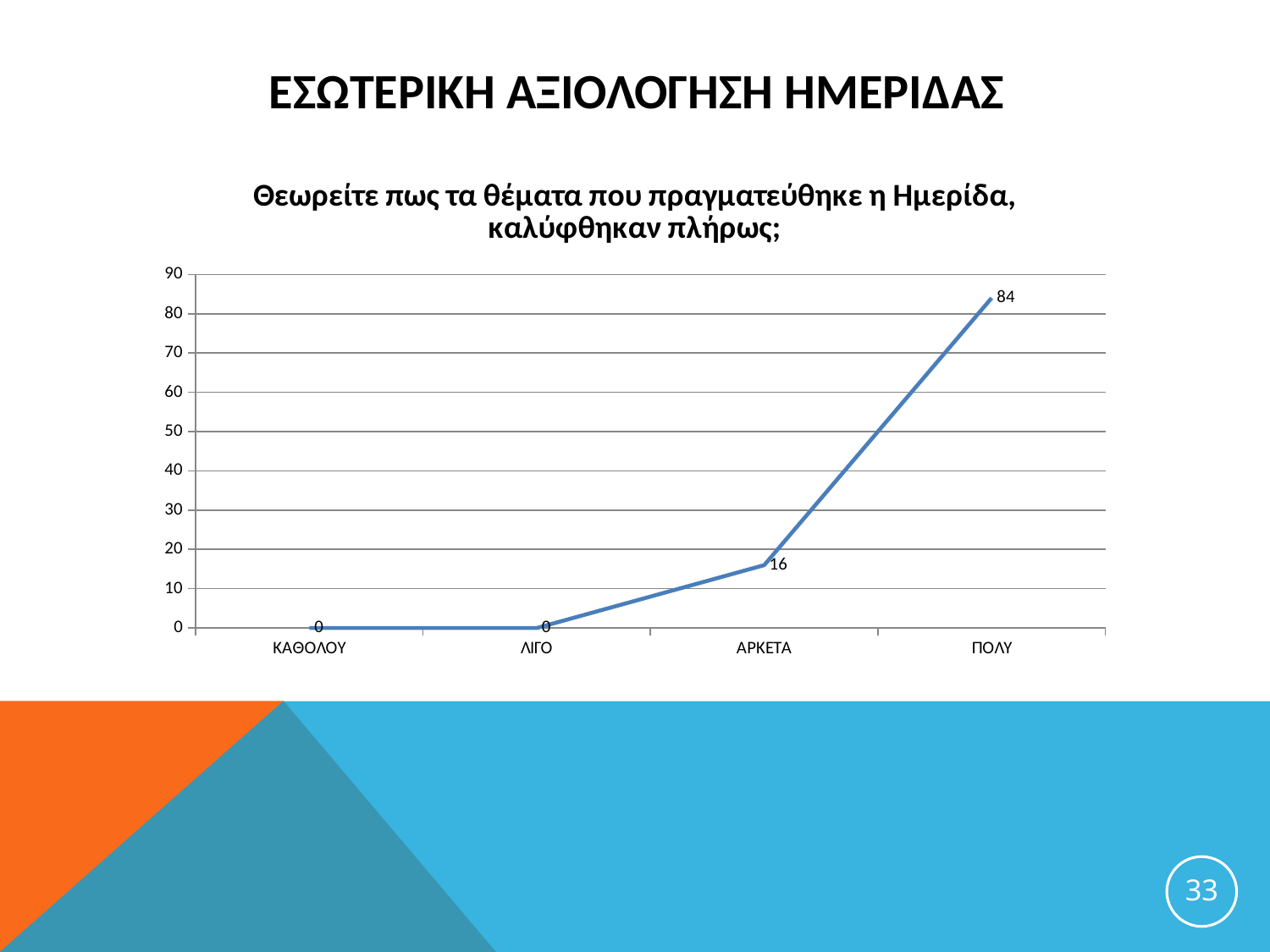
What is the title of the chart? Θεωρείτε πως τα θέματα που πραγματεύθηκε η Ημερίδα, καλύφθηκαν πλήρως; Which category has the highest value? ΠΟΛΥ What is the difference between the values for ΠΟΛΥ and ΑΡΚΕΤΑ? 68 Do the values rise or fall from ΚΑΘΟΛΟΥ to ΠΟΛΥ along the x axis? rise What is the value for ΠΟΛΥ? 84 What is the value for ΑΡΚΕΤΑ? 16 How many categories are shown on the x axis? 4 What kind of chart is shown on the slide? line chart What is the value for ΛΙΓΟ? 0 Which is larger, the value for ΑΡΚΕΤΑ or the value for ΠΟΛΥ? ΠΟΛΥ Is the value for ΠΟΛΥ greater or less than 80? greater What is the value for ΚΑΘΟΛΟΥ? 0